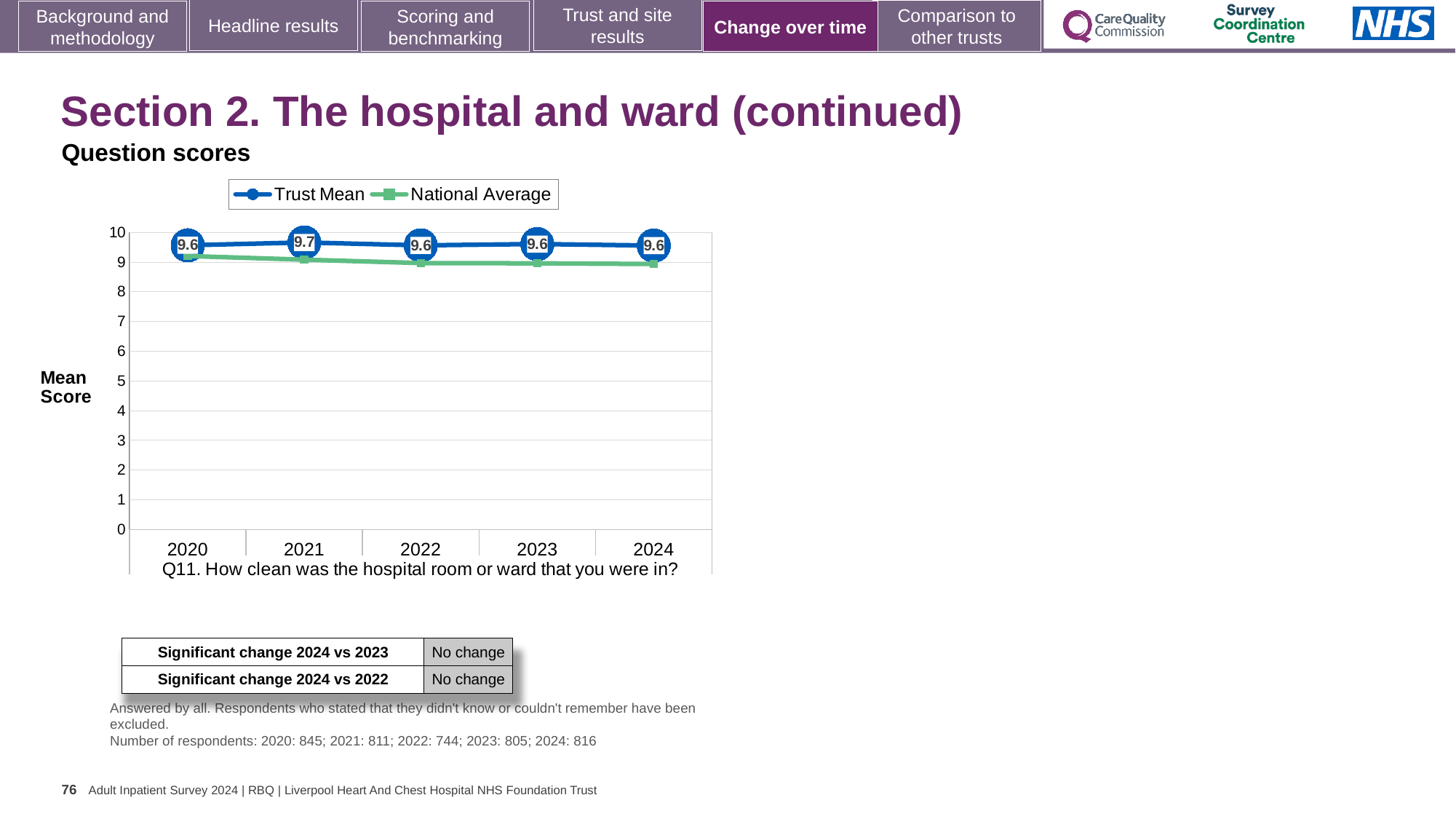
What is the difference between the Trust Mean in 2021 and in 2020? 0.1 What is the Trust Mean value for 2020? 9.6 What is the Trust Mean value for 2024? 9.6 In 2024, which is higher: the Trust Mean or the National Average? Trust Mean Is the National Average value for 2020 greater or less than 10? less How many series does the legend list? 2 In which year is the Trust Mean highest? 2021 What kind of chart is shown on the slide? Line chart What is the Trust Mean value for 2021? 9.7 Is the National Average value for 2024 greater or less than 8? greater Which survey question does the chart relate to? Q11. How clean was the hospital room or ward that you were in? How many years are shown on the x axis? 5